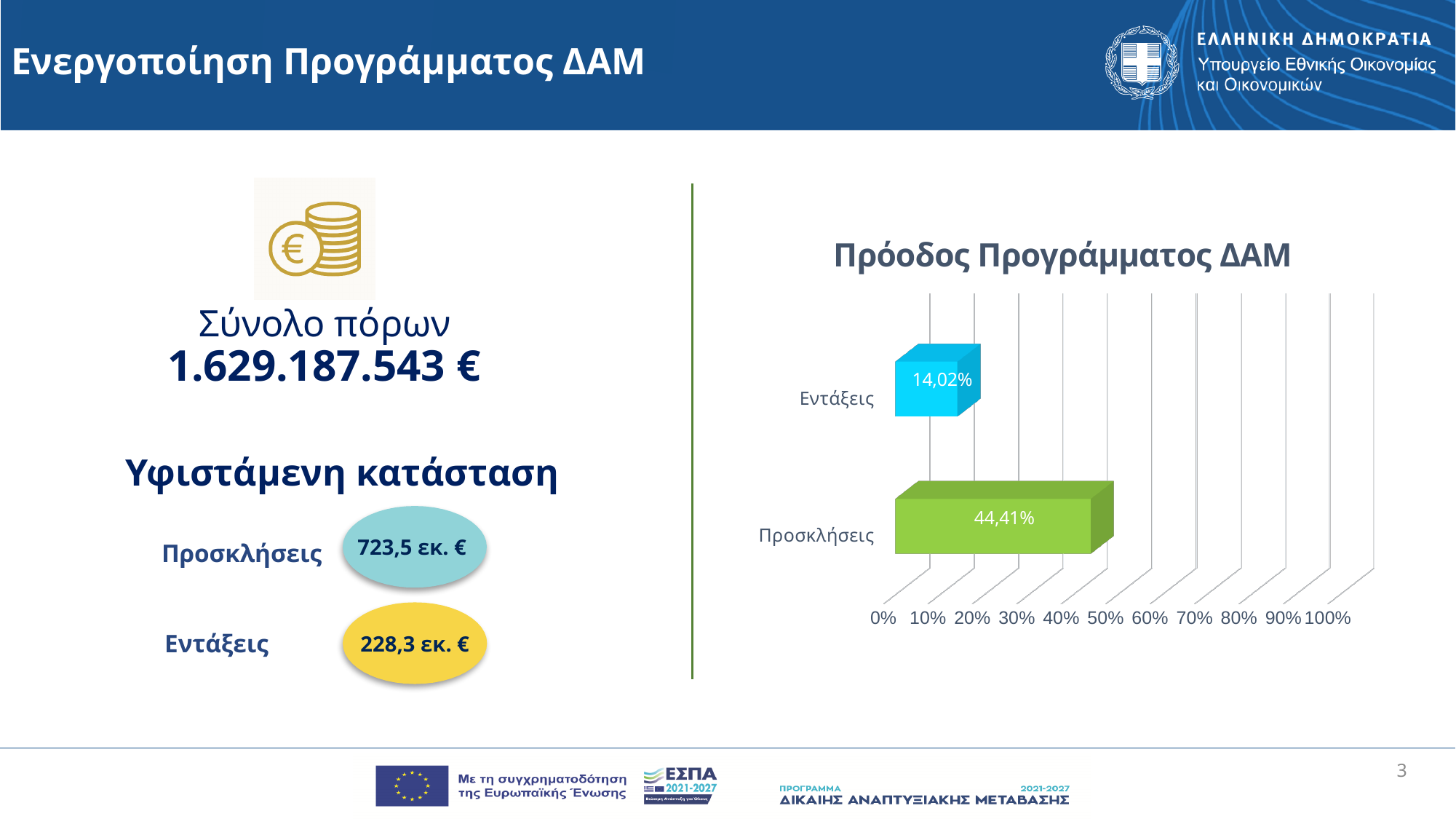
Which category has the highest value in the chart Πρόοδος Προγράμματος ΔΑΜ? Προσκλήσεις What is the value for Εντάξεις in the chart Πρόοδος Προγράμματος ΔΑΜ? 14,02% How many categories are shown in the chart Πρόοδος Προγράμματος ΔΑΜ? 2 In the chart Πρόοδος Προγράμματος ΔΑΜ, is the value for Προσκλήσεις greater or less than 50%? less What is the maximum value shown on the horizontal axis of the chart Πρόοδος Προγράμματος ΔΑΜ? 100% What kind of chart is Πρόοδος Προγράμματος ΔΑΜ? Bar chart What is the title of the chart on the right side of the slide? Πρόοδος Προγράμματος ΔΑΜ What is the difference between the values for Προσκλήσεις and Εντάξεις in the chart Πρόοδος Προγράμματος ΔΑΜ? 30,39% In the chart Πρόοδος Προγράμματος ΔΑΜ, which is larger: the value for Εντάξεις or the value for Προσκλήσεις? Προσκλήσεις What is the value for Προσκλήσεις in the chart Πρόοδος Προγράμματος ΔΑΜ? 44,41% Which category has the lowest value in the chart Πρόοδος Προγράμματος ΔΑΜ? Εντάξεις In the chart Πρόοδος Προγράμματος ΔΑΜ, is the value for Εντάξεις greater or less than 10%? greater